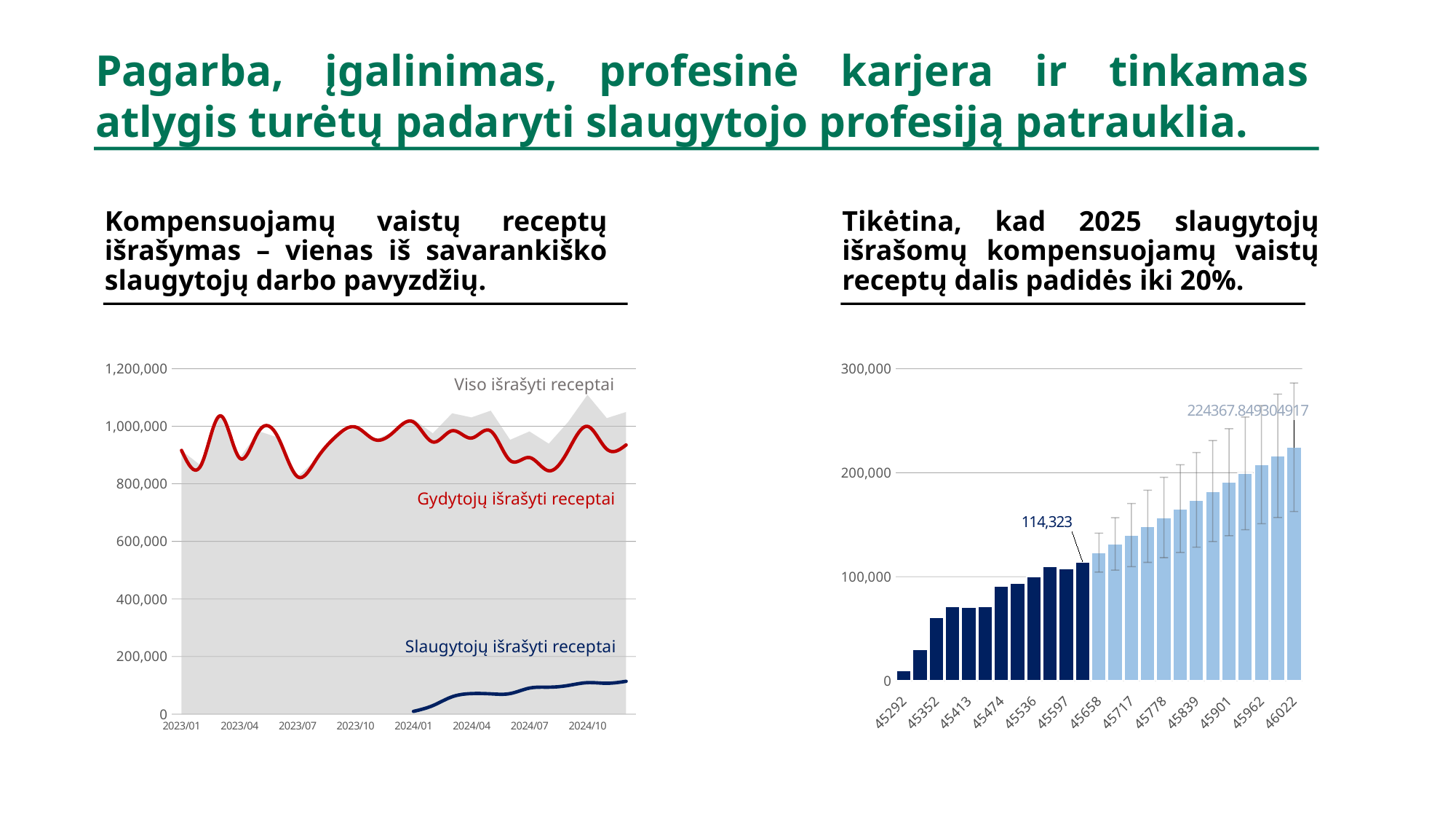
On the left chart, does the Slaugytojų išrašyti receptai line rise or fall from 2024/01 to the end of the axis? rise On the right chart, what value is labelled on the bar at 46022? 224367.849304917 On the right chart, which category has the highest bar? 46022 On the left chart, which series has the lowest values? Slaugytojų išrašyti receptai On the right chart, do the bars rise or fall from left to right along the x axis? rise What kind of chart is the chart on the right of the slide? bar chart On the right chart, is the value for 45292 greater or less than 100,000? less What kind of chart is the chart on the left of the slide? combination area and line chart On the left chart, is the value of Slaugytojų išrašyti receptai at 2024/10 greater or less than 200,000? less On the left chart, is the value of Gydytojų išrašyti receptai at 2023/01 greater or less than 800,000? greater How many series are labelled on the left chart? 3